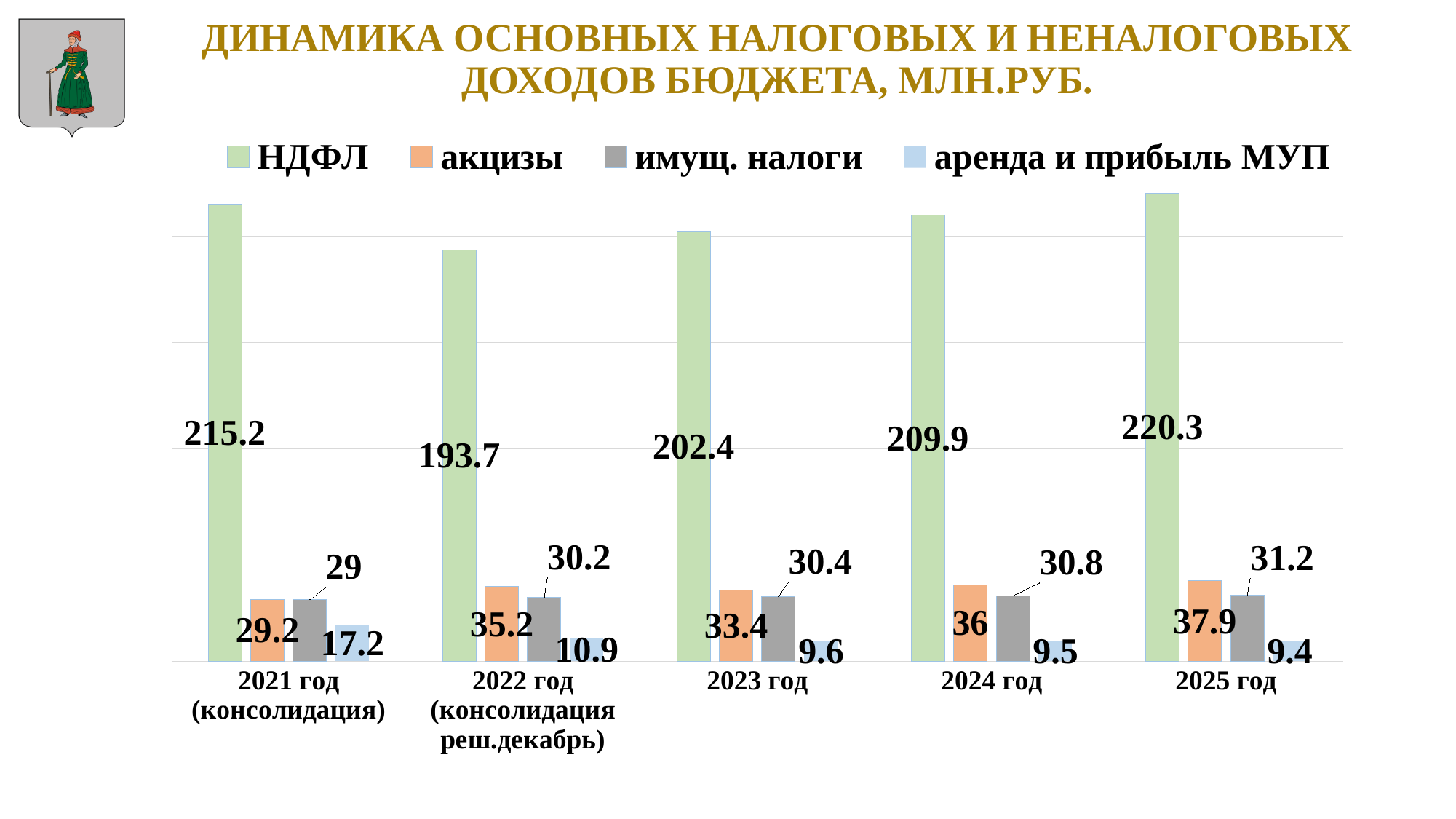
What is the value of НДФЛ for 2025 год? 220.3 How many years (categories) are shown on the x axis? 5 In which year is НДФЛ the highest? 2025 год What is the difference between НДФЛ in 2025 год and НДФЛ in 2021 год (консолидация)? 5.1 In which year is НДФЛ the lowest? 2022 год (консолидация реш.декабрь) Do the values for акцизы rise or fall from 2021 год to 2025 год? rise What kind of chart is shown on the slide? bar chart How many series does the legend list? 4 What is the value of аренда и прибыль МУП for 2021 год (консолидация)? 17.2 Which is larger: акцизы in 2023 год or имущ. налоги in 2023 год? акцизы What is the value of акцизы for 2022 год (консолидация реш.декабрь)? 35.2 What is the value of имущ. налоги for 2024 год? 30.8